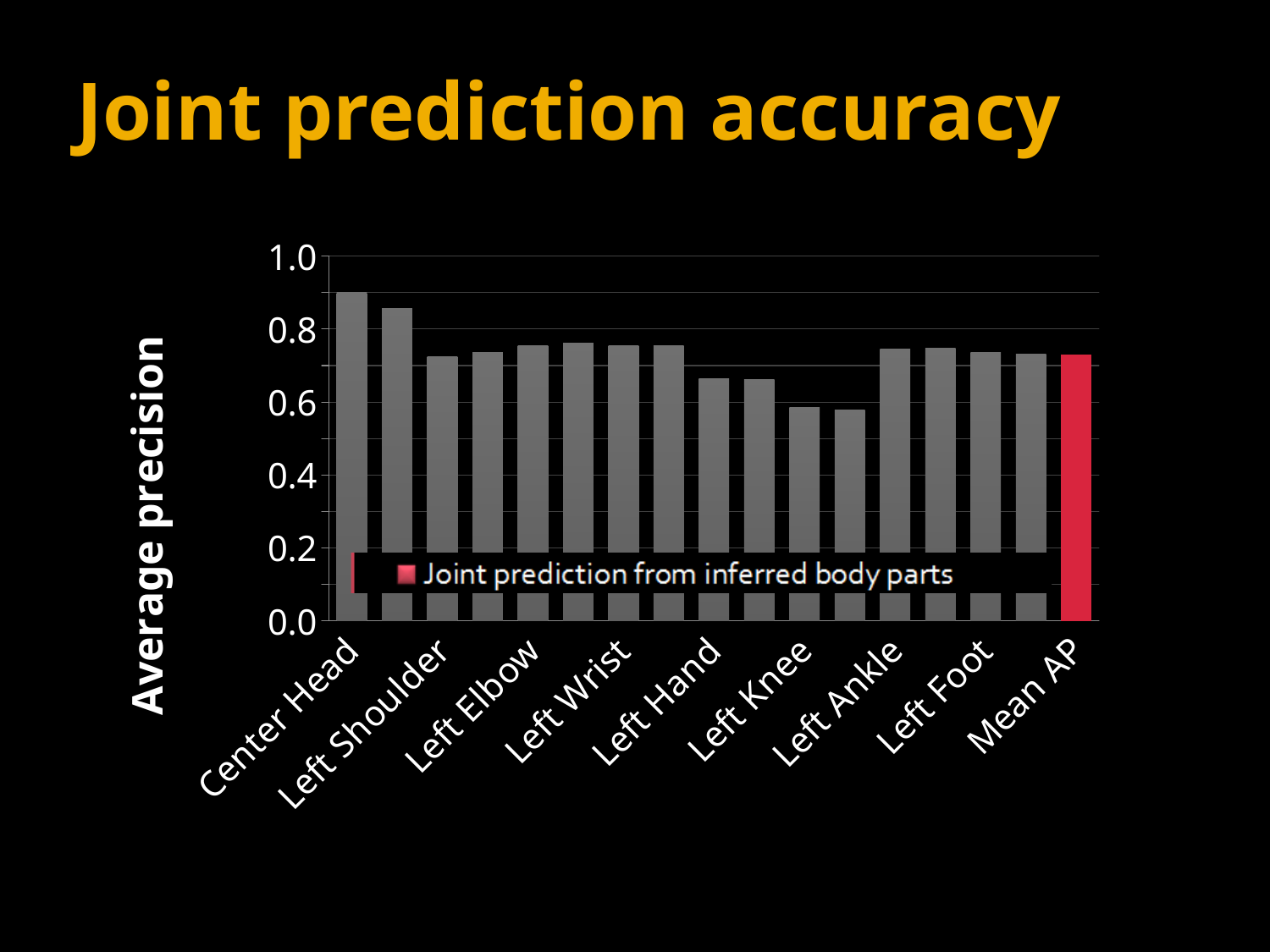
Is the value for Left Knee greater or less than 0.8? less Which is larger, the value for Left Elbow or the value for Left Hand? Left Elbow Which category has the highest average precision? Center Head Is the value for Left Hand greater or less than 0.8? less What kind of chart is shown on the slide? bar chart What is the legend entry shown on the chart? Joint prediction from inferred body parts What is the title of the y axis? Average precision Is the value for Left Shoulder greater or less than 0.6? greater Which is larger, the value for Center Head or the value for Left Knee? Center Head How many series does the legend list? 1